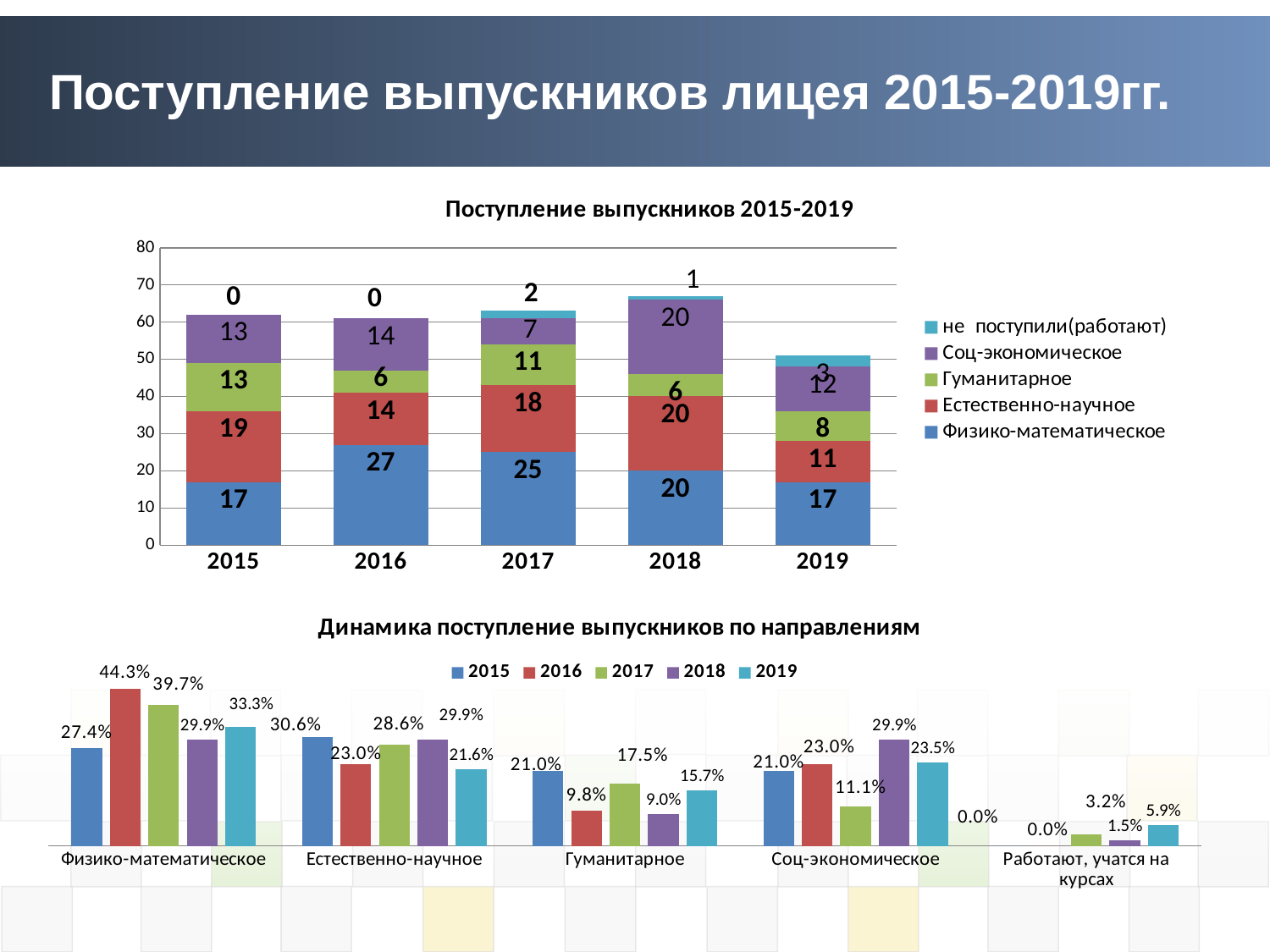
In the top chart 'Поступление выпускников 2015-2019', how many series does the legend list? 5 In the bottom chart 'Динамика поступление выпускников по направлениям', which year has the lowest value in the Гуманитарное category? 2018 In the top chart 'Поступление выпускников 2015-2019', which year has the highest value for не поступили(работают)? 2019 In the top chart 'Поступление выпускников 2015-2019', what is the value for Соц-экономическое in 2018? 20 In the top chart 'Поступление выпускников 2015-2019', what is the total of the stacked bar for 2019? 51 In the bottom chart 'Динамика поступление выпускников по направлениям', which is larger in the Соц-экономическое category: 2018 or 2019? 2018 In the top chart 'Поступление выпускников 2015-2019', what is the total of the stacked bar for 2018? 67 In the top chart 'Поступление выпускников 2015-2019', what is the value for Физико-математическое in 2016? 27 What kind of chart is the bottom chart 'Динамика поступление выпускников по направлениям'? Bar chart In the top chart 'Поступление выпускников 2015-2019', what is the difference between the Естественно-научное values for 2015 and 2019? 8 In the bottom chart 'Динамика поступление выпускников по направлениям', what is the value for 2016 in the Физико-математическое category? 44.3% In the bottom chart 'Динамика поступление выпускников по направлениям', how many categories are shown on the x axis? 5